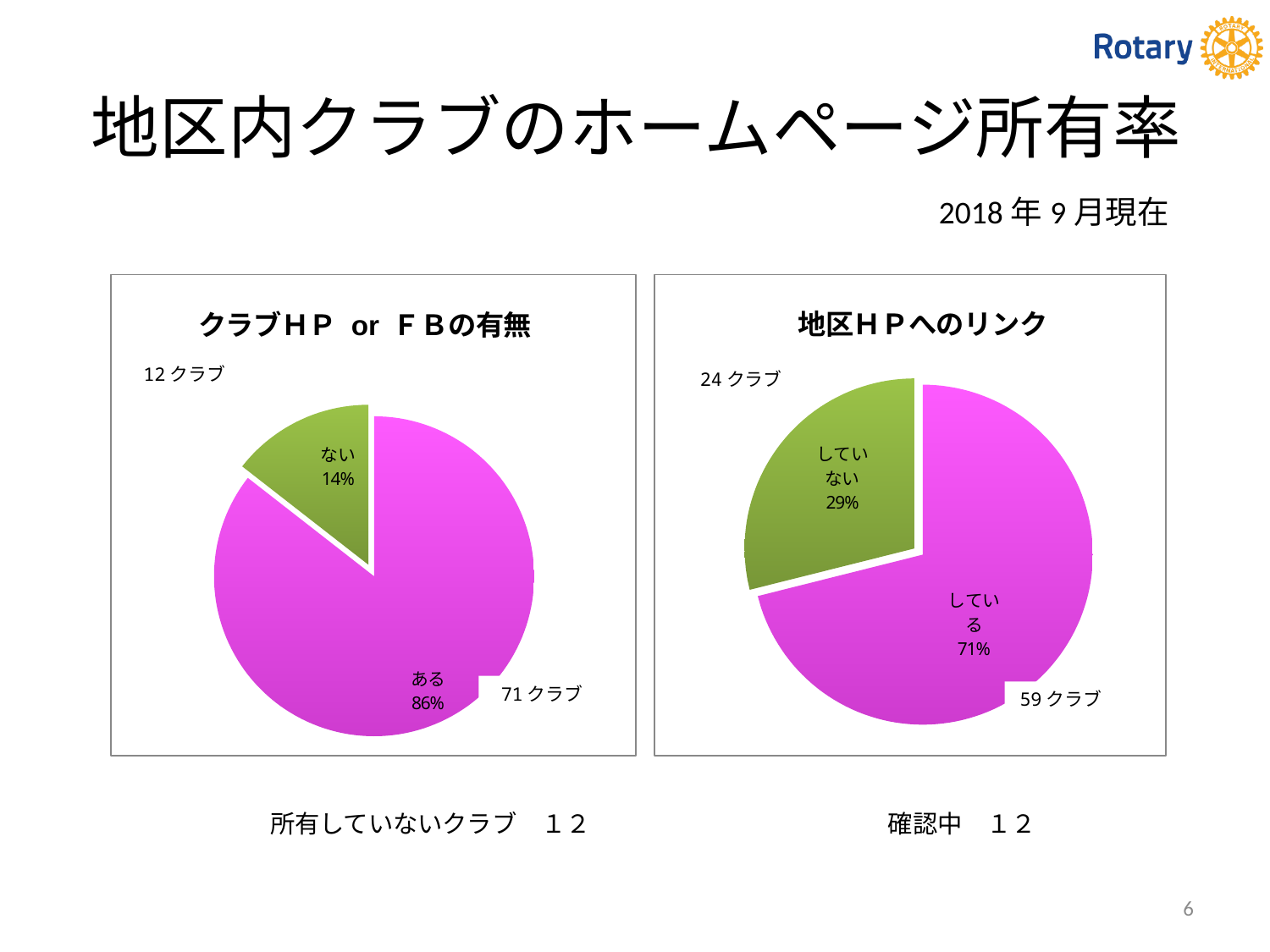
In the right chart titled 地区ＨＰへのリンク, what is the difference in club count between the している and していない slices? 35 In the left chart titled クラブＨＰ or ＦＢの有無, which slice is the largest? ある In the left chart titled クラブＨＰ or ＦＢの有無, what percentage share does the ある slice have? 86% In the right chart titled 地区ＨＰへのリンク, how many clubs does the している slice represent? 59 クラブ In the right chart titled 地区ＨＰへのリンク, what percentage share does the していない slice have? 29% What type of chart is the right chart titled 地区ＨＰへのリンク? Pie chart In the left chart titled クラブＨＰ or ＦＢの有無, what percentage share does the ない slice have? 14% In the right chart titled 地区ＨＰへのリンク, which slice is the smallest? していない In the left chart titled クラブＨＰ or ＦＢの有無, how many clubs does the ない slice represent? 12 クラブ In the right chart titled 地区ＨＰへのリンク, how many clubs does the していない slice represent? 24 クラブ In the left chart titled クラブＨＰ or ＦＢの有無, how many clubs does the ある slice represent? 71 クラブ